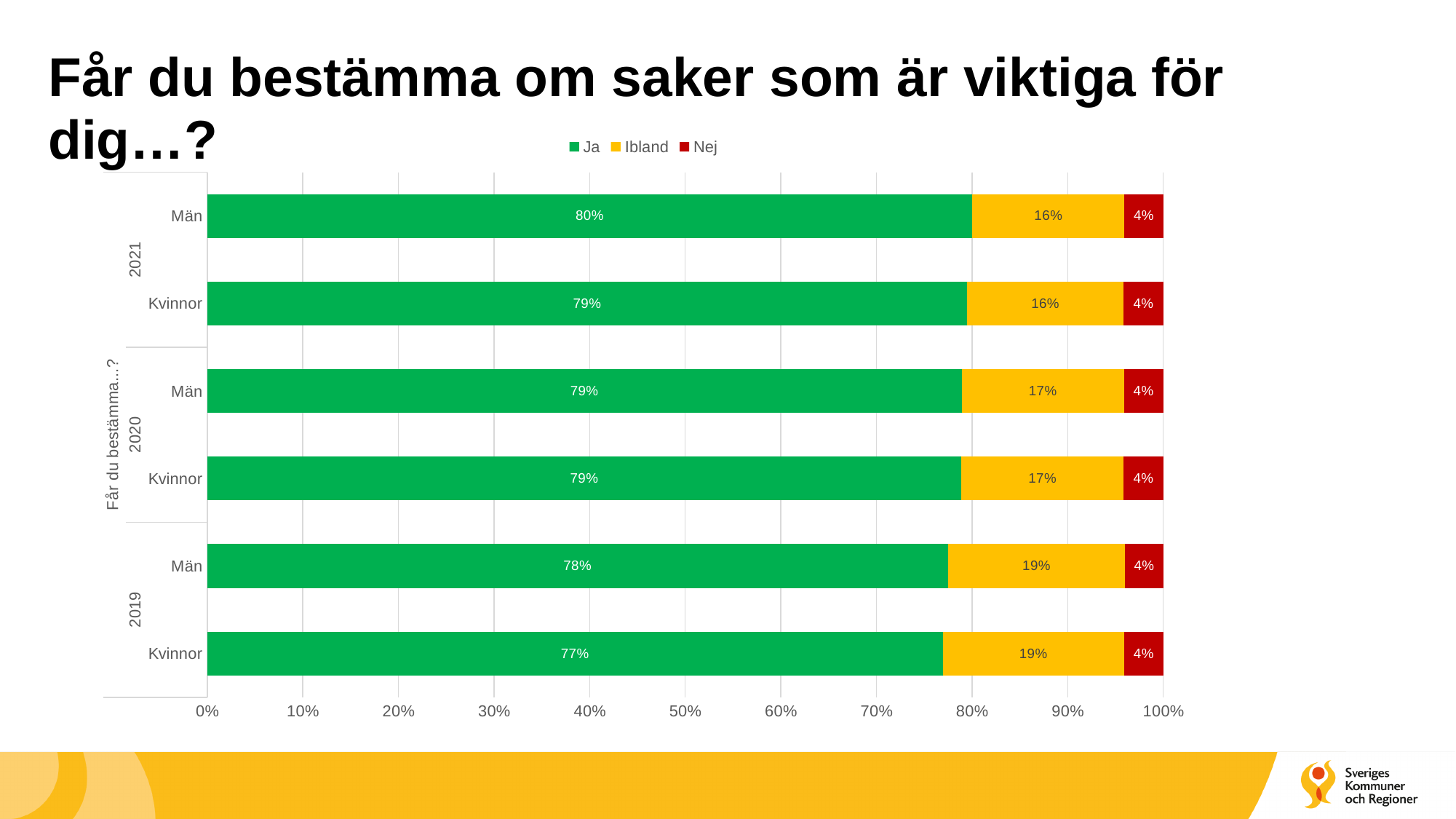
Which is larger: the "Ibland" value for Män in 2019 or the "Ibland" value for Män in 2021? Män in 2019 Which bar has the lowest "Ja" value? Kvinnor 2019 Which series is shown in red in the legend? Nej What is the "Ja" value for Män in 2021? 80% What is the "Ibland" value for Kvinnor in 2019? 19% What kind of chart is shown on the slide? Stacked bar chart How many series does the legend list? 3 How many bars are plotted in the chart? 6 Which bar has the highest "Ja" value? Män 2021 What is the "Nej" value for Män in 2020? 4% What is the difference between the "Ja" value for Män in 2021 and the "Ja" value for Kvinnor in 2019? 3% What is the "Ja" value for Kvinnor in 2019? 77%